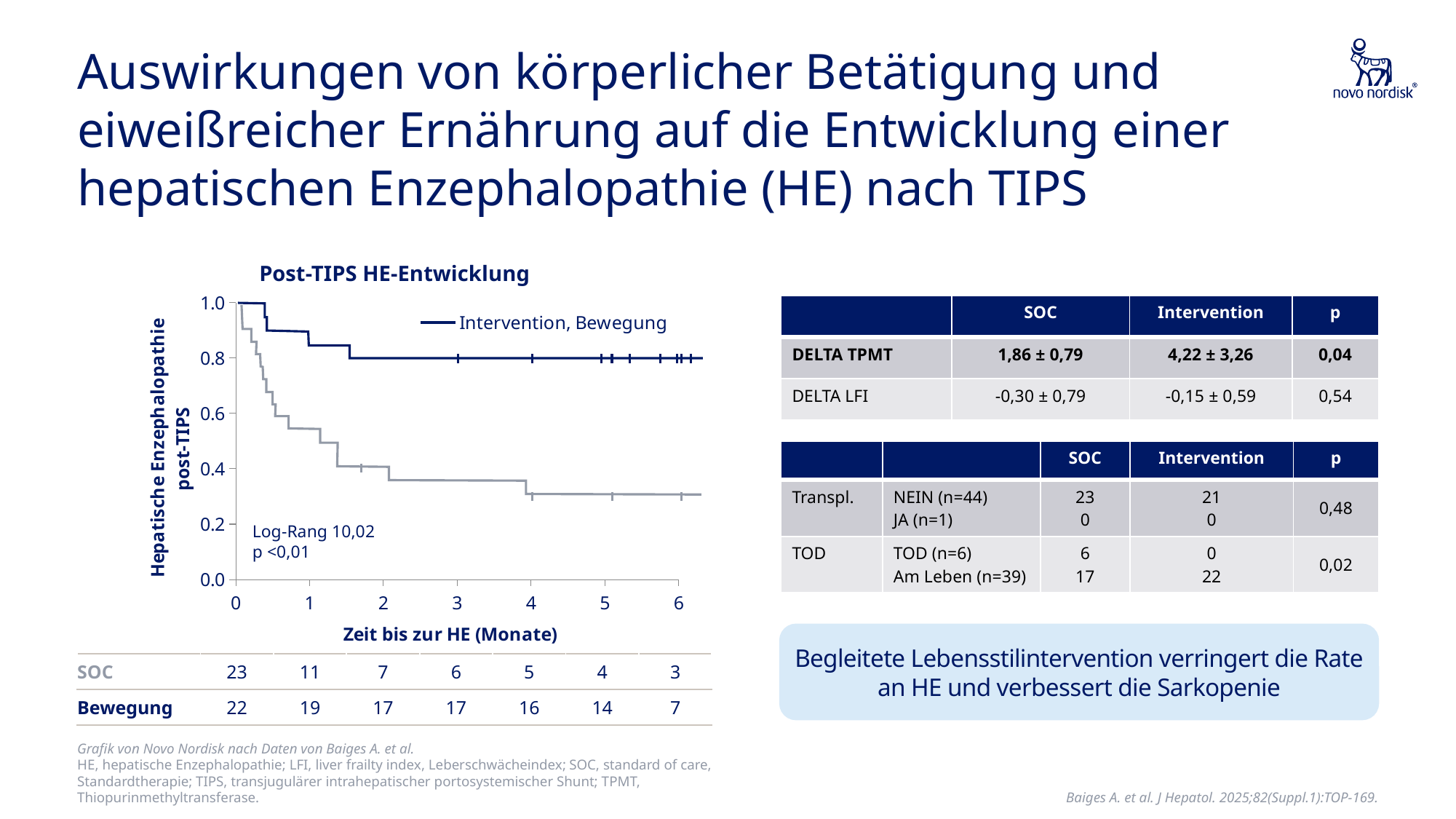
What kind of chart is shown under the title "Post-TIPS HE-Entwicklung"? line chart How many series does the legend of the chart list? 1 Is the value of the "Intervention, Bewegung" curve at 6 months greater or less than 0.6? greater What is the label of the x axis of the chart? Zeit bis zur HE (Monate) In the number-at-risk table below the chart, what is the difference between the Bewegung and SOC values at 2 months? 10 At 3 months, which curve is higher: "Intervention, Bewegung" or the grey SOC curve? Intervention, Bewegung Is the value of the lower (grey, SOC) curve at 6 months greater or less than 0.4? less In the number-at-risk table below the chart, what is the SOC value at 0 months? 23 What is the title of the chart on the left of the slide? Post-TIPS HE-Entwicklung In the number-at-risk table below the chart, what is the Bewegung value at 6 months? 7 What Log-Rang value is printed on the chart? 10,02 Do the curves in the chart rise or fall as time along the x axis increases? fall